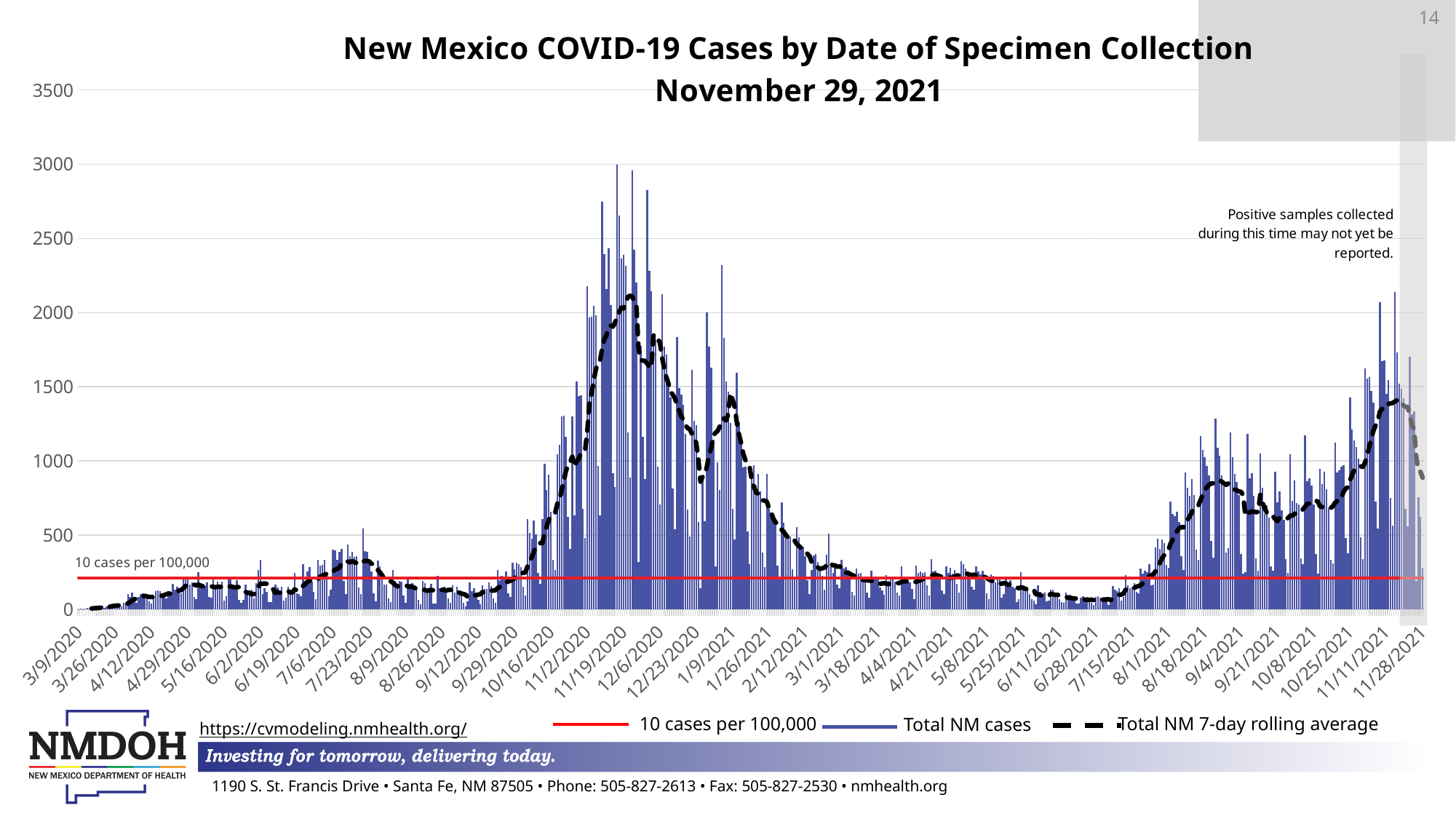
Is the tallest daily case bar, near 11/19/2020, greater or less than 2500? greater What does the red horizontal line represent according to the legend? 10 cases per 100,000 Does the Total NM 7-day rolling average rise or fall between 12/6/2020 and 2/12/2021? fall Around which labeled date on the x axis do the daily case bars reach their highest point? 11/19/2020 How many series does the legend list? 3 What is the title of the chart? New Mexico COVID-19 Cases by Date of Specimen Collection November 29, 2021 Is the Total NM 7-day rolling average around 6/28/2021 greater or less than 500? less Is the peak of the Total NM 7-day rolling average around 11/19/2020 greater or less than 1500? greater What kind of chart is shown on the slide? Bar chart with line overlays Does the Total NM 7-day rolling average rise or fall between 7/15/2021 and 8/18/2021? rise Which is higher: the peak of the 7-day rolling average in November 2020 or the peak in November 2021? November 2020